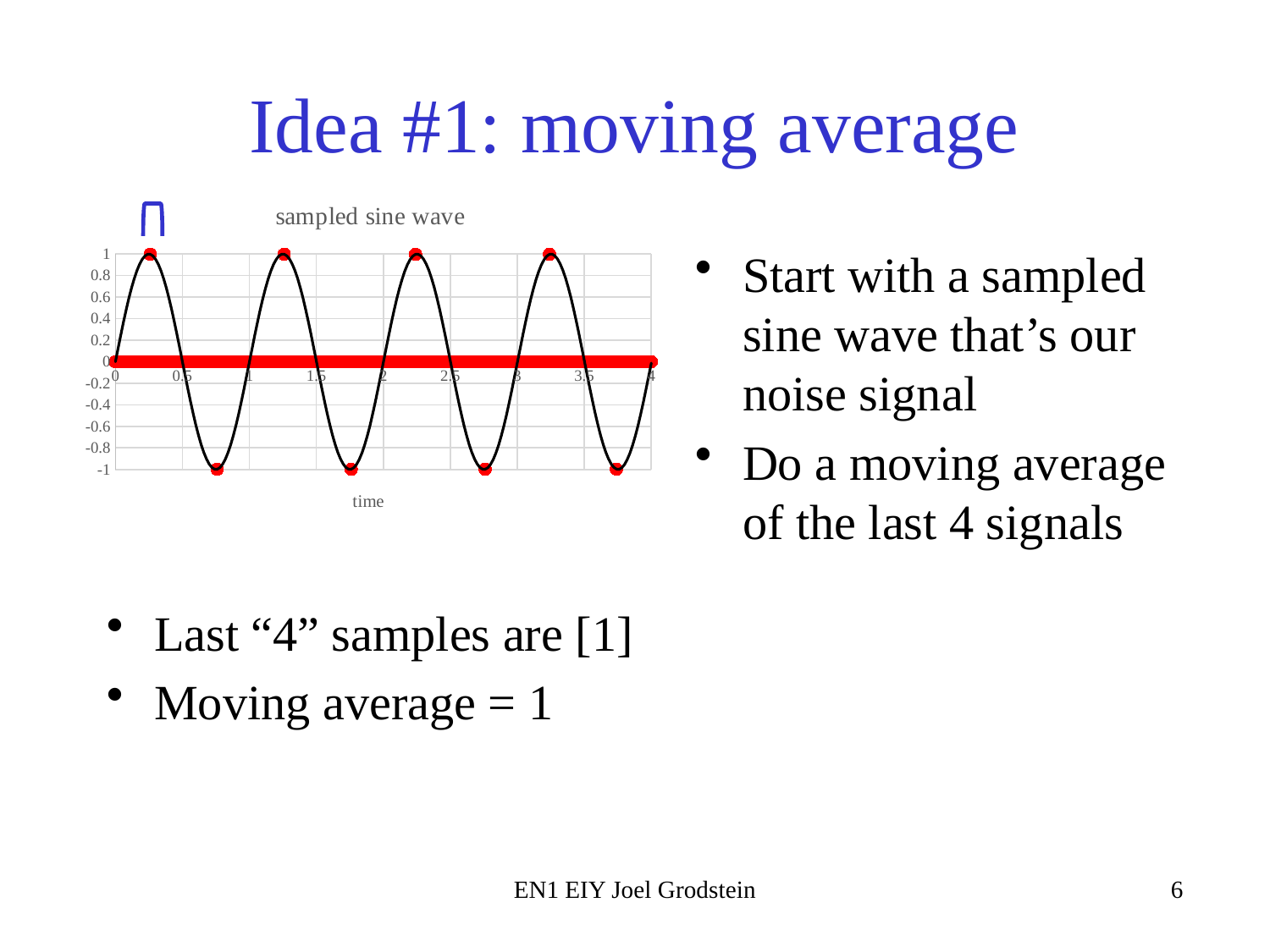
What is the difference between the highest and lowest values of the sine wave on the chart? 2 What is the lowest value reached by the sine wave on the chart? -1 How many peaks (maxima) does the sine wave have on the chart? 4 What kind of chart is shown on the slide? line chart What is the highest value reached by the sine wave on the chart? 1 What is the largest value shown on the x axis of the chart? 4 Does the sine wave rise or fall between time 0 and time 0.25? rise How many troughs (minima) does the sine wave have on the chart? 4 What is the label of the x axis of the chart? time Is the value of the sine wave at time 0.75 greater or less than -0.8? less Is the value of the sine wave at time 0.25 greater or less than 0.8? greater What is the title of the chart? sampled sine wave